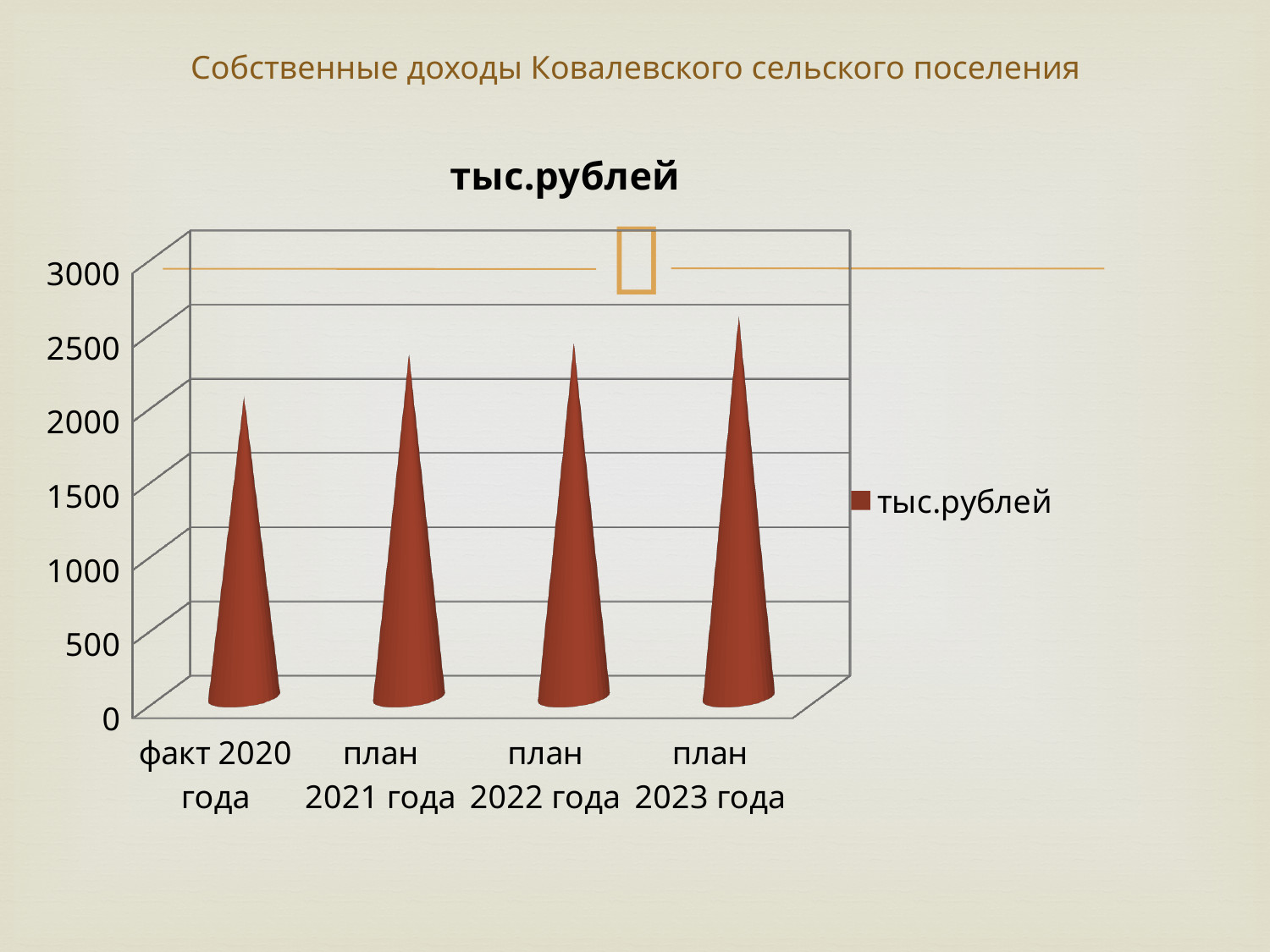
How many series does the legend list? 1 Is the value for план 2023 года greater or less than 2500? greater Which category has the lowest value? факт 2020 года Do the values rise or fall from факт 2020 года to план 2023 года? rise What is the legend entry shown on the chart? тыс.рублей What kind of chart is shown on the slide? bar chart Which category has the highest value? план 2023 года Is the value for план 2021 года greater or less than 2000? greater Is the value for план 2022 года greater or less than 3000? less Which is larger, the value for факт 2020 года or the value for план 2023 года? план 2023 года How many categories are plotted on the x axis? 4